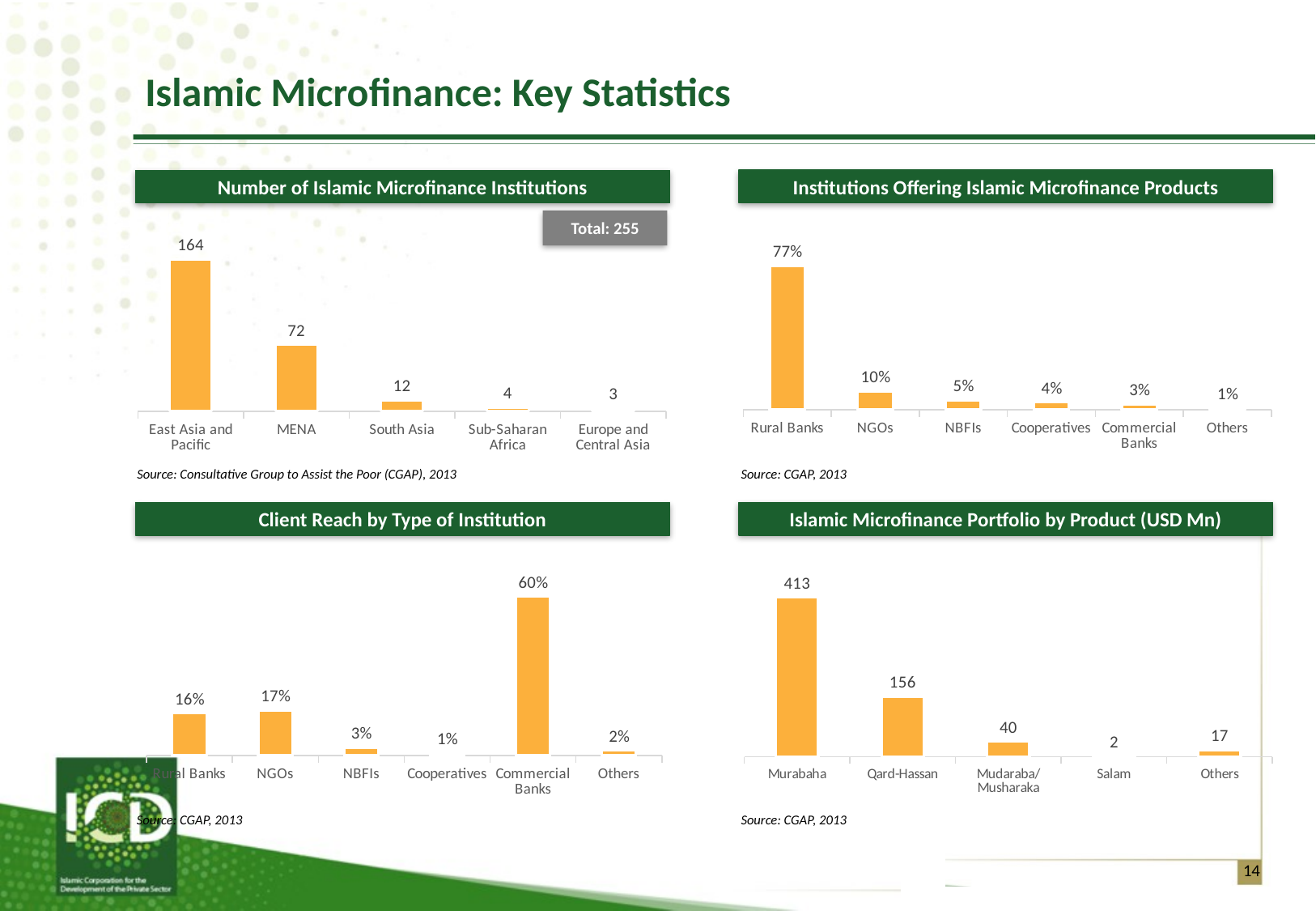
In the 'Institutions Offering Islamic Microfinance Products' chart, which category has the lowest value? Others In the 'Number of Islamic Microfinance Institutions' chart, what is the value for MENA? 72 In the 'Islamic Microfinance Portfolio by Product (USD Mn)' chart, what is the difference between Murabaha and Qard-Hassan? 257 In the 'Client Reach by Type of Institution' chart, what is the value for Commercial Banks? 60% In the 'Islamic Microfinance Portfolio by Product (USD Mn)' chart, what is the value for Qard-Hassan? 156 In the 'Institutions Offering Islamic Microfinance Products' chart, what is the value for Rural Banks? 77% In the 'Number of Islamic Microfinance Institutions' chart, what total is shown on the slide? Total: 255 In the 'Number of Islamic Microfinance Institutions' chart, what is the difference between East Asia and Pacific and MENA? 92 What type of chart is the 'Islamic Microfinance Portfolio by Product (USD Mn)' chart? Bar chart In the 'Number of Islamic Microfinance Institutions' chart, which region has the highest number of institutions? East Asia and Pacific In the 'Institutions Offering Islamic Microfinance Products' chart, how many categories are shown? 6 In the 'Client Reach by Type of Institution' chart, which is larger, Rural Banks or NGOs? NGOs